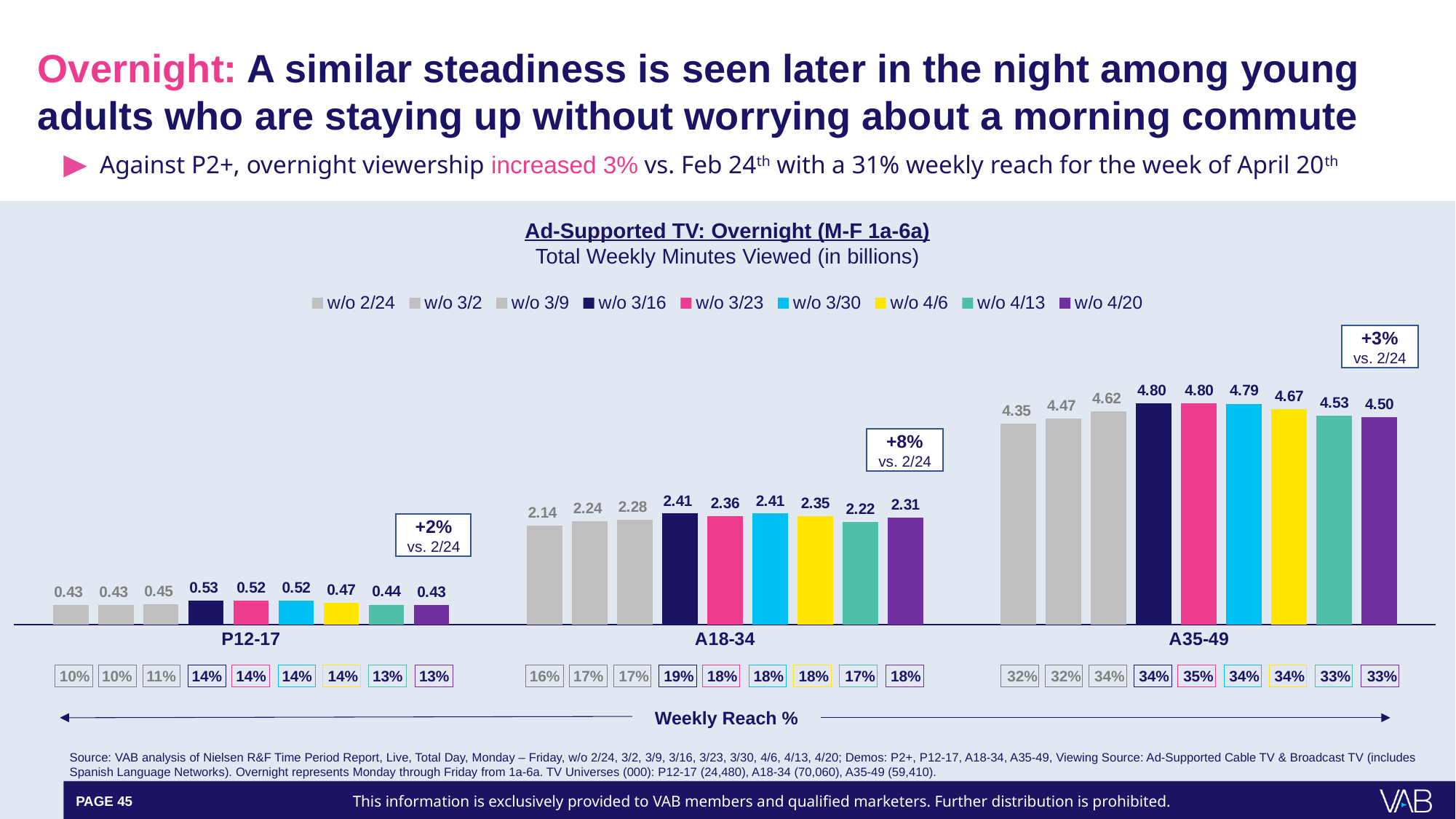
How many demographic groups are shown on the x axis? 3 How many series does the legend list? 9 Within the A35-49 group, which week has the lowest value? w/o 2/24 For A18-34, which is larger: the w/o 3/23 value or the w/o 4/13 value? w/o 3/23 What is the difference between the A35-49 values for w/o 3/16 and w/o 2/24? 0.45 What is the weekly reach % shown for A35-49 in the w/o 3/23 series? 35% What is the value for P12-17 in the w/o 4/6 series? 0.47 What kind of chart is shown on the slide? Bar chart Within the P12-17 group, which week has the highest value? w/o 3/16 What is the value for A18-34 in the w/o 3/16 series? 2.41 What is the value for A35-49 in the w/o 4/20 series? 4.50 What percentage change vs. 2/24 is annotated above the A18-34 group? +8%